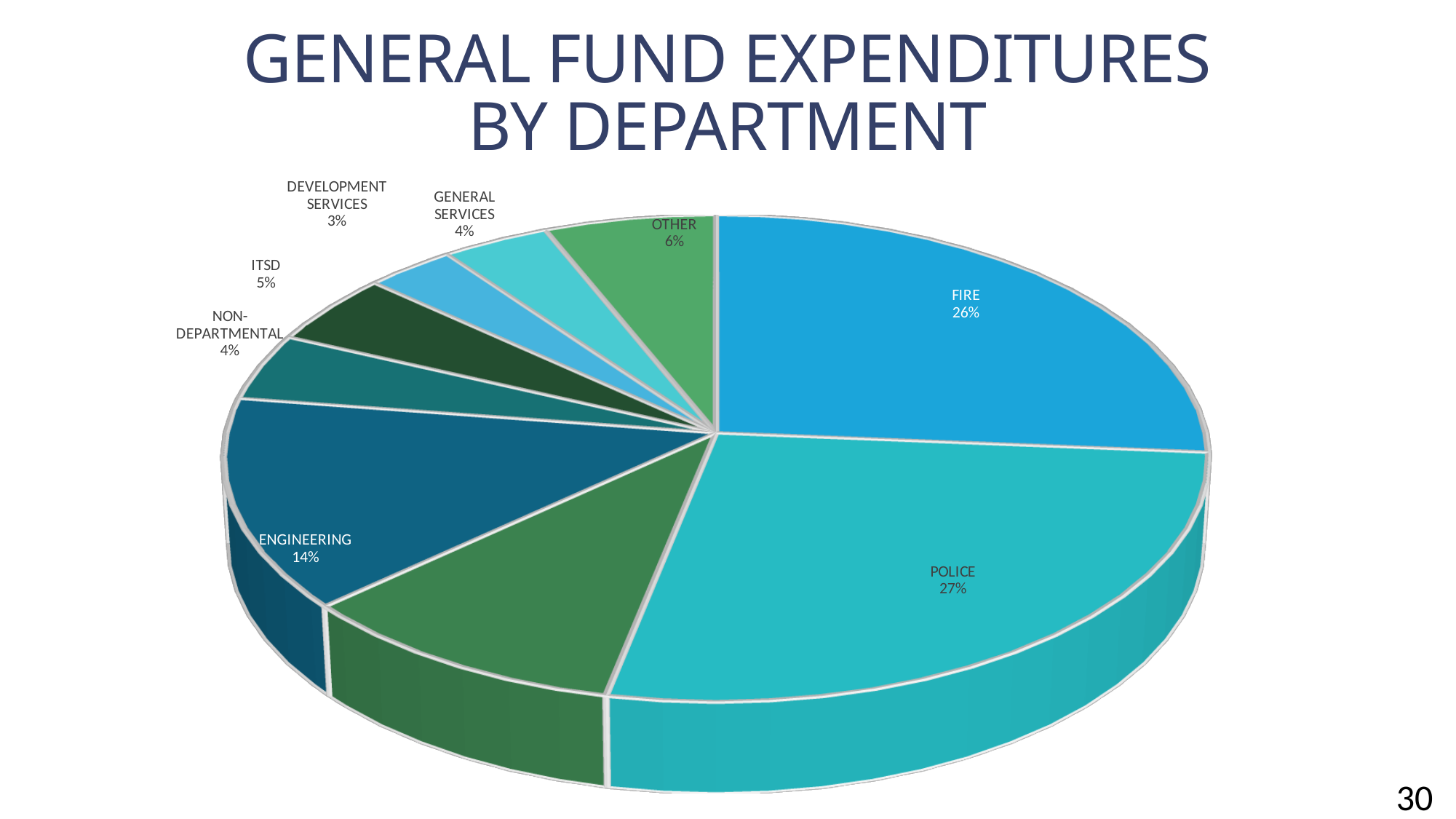
Which labeled department has the smallest share of expenditures? DEVELOPMENT SERVICES What share of general fund expenditures goes to POLICE? 27% What type of chart is shown on the slide? pie chart What share of general fund expenditures goes to FIRE? 26% Which has a larger share, FIRE or ENGINEERING? FIRE What is the title of the chart? GENERAL FUND EXPENDITURES BY DEPARTMENT What is the difference in percentage points between POLICE and ENGINEERING? 13 Which labeled department has the largest share of expenditures? POLICE What percentage is shown for ENGINEERING? 14% What percentage is shown for OTHER? 6% What percentage is shown for ITSD? 5% What percentage is shown for DEVELOPMENT SERVICES? 3%